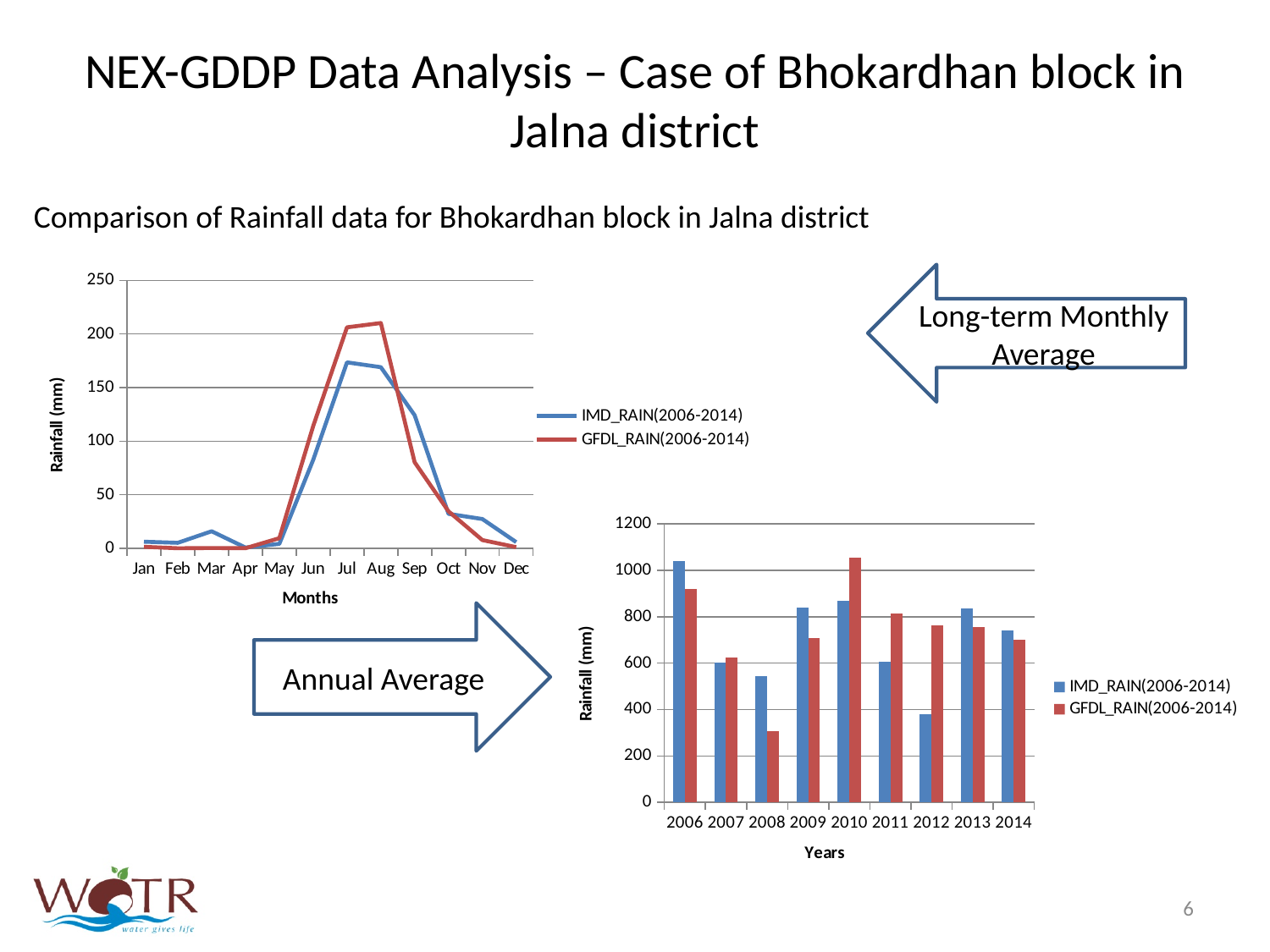
In the monthly line chart, how many months are shown on the x axis? 12 In the monthly line chart, in which month does the GFDL_RAIN(2006-2014) series reach its highest value? Aug What kind of chart is the chart on the left showing rainfall by month? line chart In the monthly line chart, is the IMD_RAIN(2006-2014) value for Sep greater or less than 100? greater In the monthly line chart, how many series does the legend list? 2 In the monthly line chart, in which month does the IMD_RAIN(2006-2014) series reach its highest value? Jul What kind of chart is the chart on the right showing rainfall by year? bar chart In the annual bar chart, how many years are shown on the x axis? 9 In the annual bar chart, which year has the highest IMD_RAIN(2006-2014) value? 2006 In the annual bar chart, which year has the lowest GFDL_RAIN(2006-2014) value? 2008 In the monthly line chart, is the GFDL_RAIN(2006-2014) value for Aug greater or less than 200? greater In the annual bar chart, which series has the larger value in 2008, IMD_RAIN(2006-2014) or GFDL_RAIN(2006-2014)? IMD_RAIN(2006-2014)